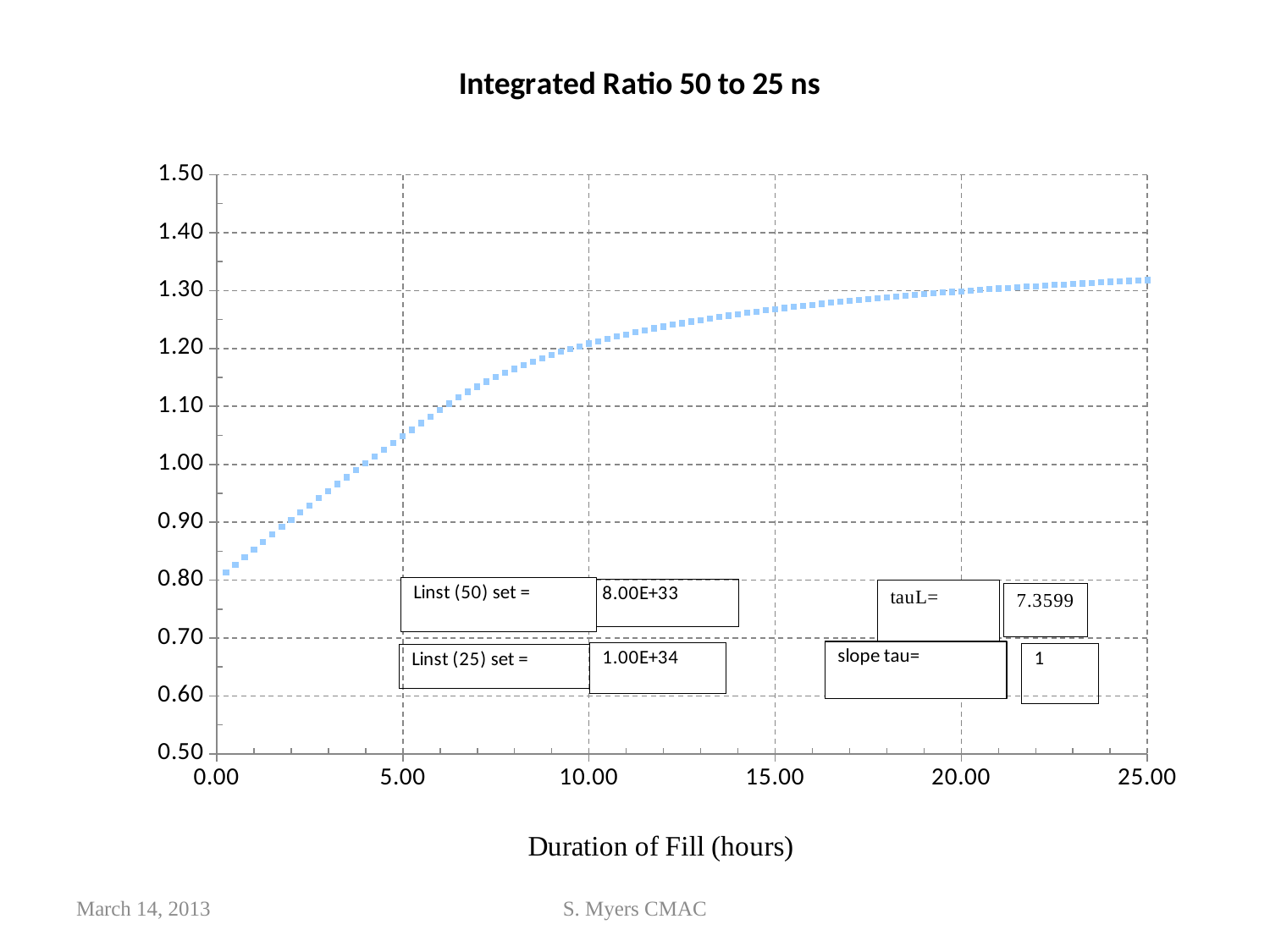
Is the value at a duration of 5.00 hours greater or less than 1.00? greater What kind of chart is shown on the slide? scatter chart Is the value at the start of the fill (0.00 hours) greater or less than 0.90? less Is the value at a duration of 25.00 hours greater or less than 1.30? greater What value is shown for tauL in the annotation box on the chart? 7.3599 Which is larger, the value at 5.00 hours or the value at 20.00 hours? 20.00 hours Do the plotted values rise or fall as the duration of fill increases? rise What is the title of the chart? Integrated Ratio 50 to 25 ns